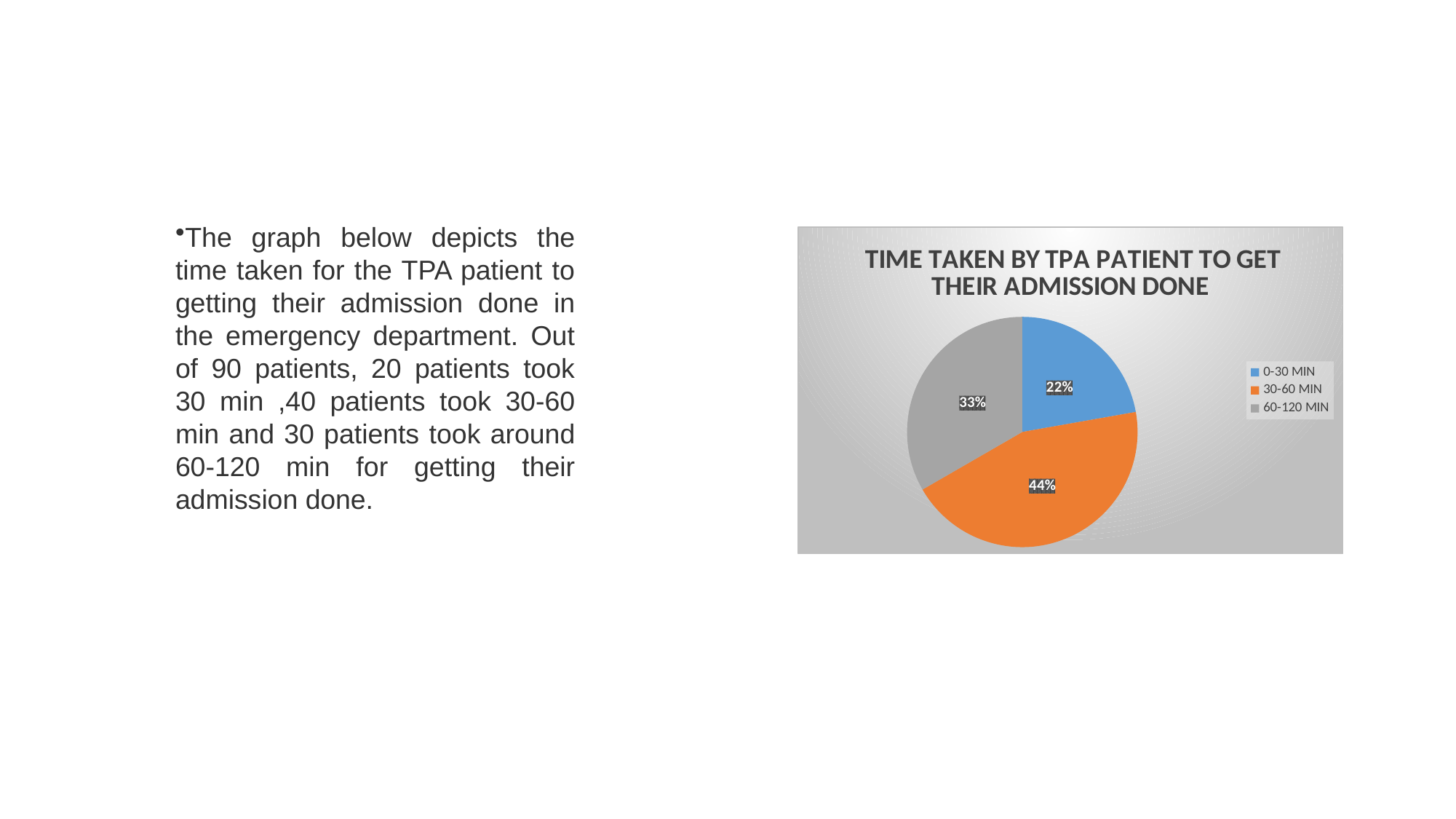
How many slices does the pie chart have? 3 What percentage of the pie is the 60-120 MIN slice? 33% What percentage of the pie is the 0-30 MIN slice? 22% Which category has the smallest share of the pie? 0-30 MIN What colour is the 30-60 MIN slice? orange Which category has the largest share of the pie? 30-60 MIN What is the difference in percentage points between the 30-60 MIN slice and the 0-30 MIN slice? 22 How many entries does the legend list? 3 What percentage of the pie is the 30-60 MIN slice? 44% Which slice is larger, 60-120 MIN or 0-30 MIN? 60-120 MIN What kind of chart is shown on the slide? pie chart What is the title of the chart? TIME TAKEN BY TPA PATIENT TO GET THEIR ADMISSION DONE